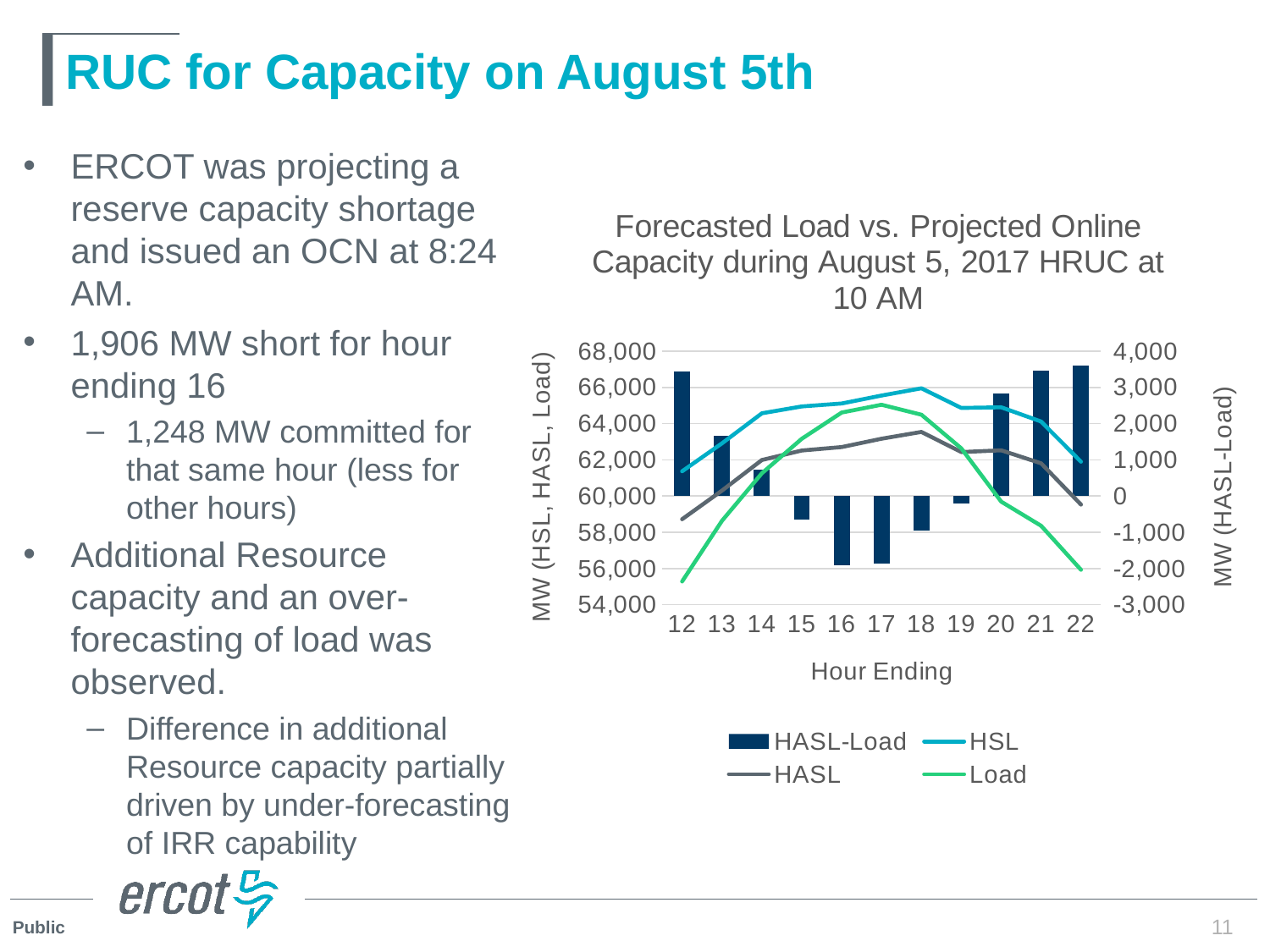
Is the HASL value for hour ending 12 greater or less than 60,000? less Which series is plotted as bars in the chart? HASL-Load What is the label of the x axis? Hour Ending How many hour-ending categories are plotted on the x axis? 11 At which hour ending does the Load series reach its highest value? 17 Is the HASL-Load value for hour ending 16 greater or less than -1,000? less Does the Load series rise or fall from hour ending 12 to hour ending 17? rise What kind of chart is shown on the slide? A combined bar and line chart Is the HASL-Load value for hour ending 22 greater or less than 3,000? greater At which hour ending is the Load series lowest? 12 How many series does the chart legend list? 4